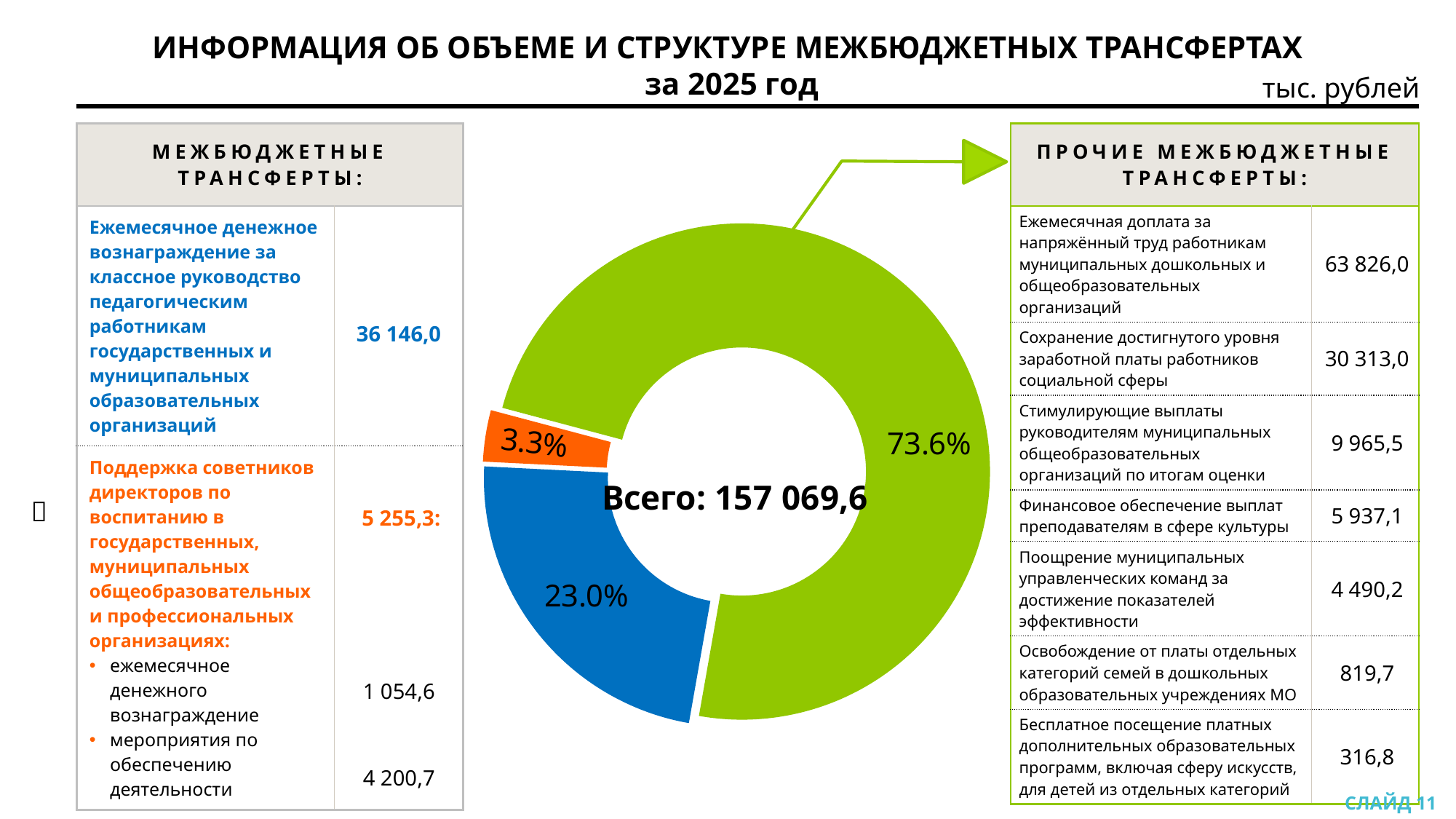
What percentage is shown on the orange slice of the donut chart? 3.3% Which is larger in the donut chart, the blue slice or the orange slice? The blue slice What percentage is shown on the largest (green) slice of the donut chart? 73.6% Is the share of the blue slice in the donut chart greater or less than 25%? less What percentage is shown on the blue slice of the donut chart? 23.0% What total value is printed in the centre of the donut chart? Всего: 157 069,6 Which slice of the donut chart is the largest? The green slice (73.6%) What is the unit of measurement stated at the top right of the slide for the chart values? тыс. рублей How many slices does the donut chart have? 3 By how many percentage points does the green slice exceed the blue slice in the donut chart? 50.6 percentage points What kind of chart is shown in the centre of the slide? Pie chart (donut) Which slice of the donut chart is the smallest? The orange slice (3.3%)